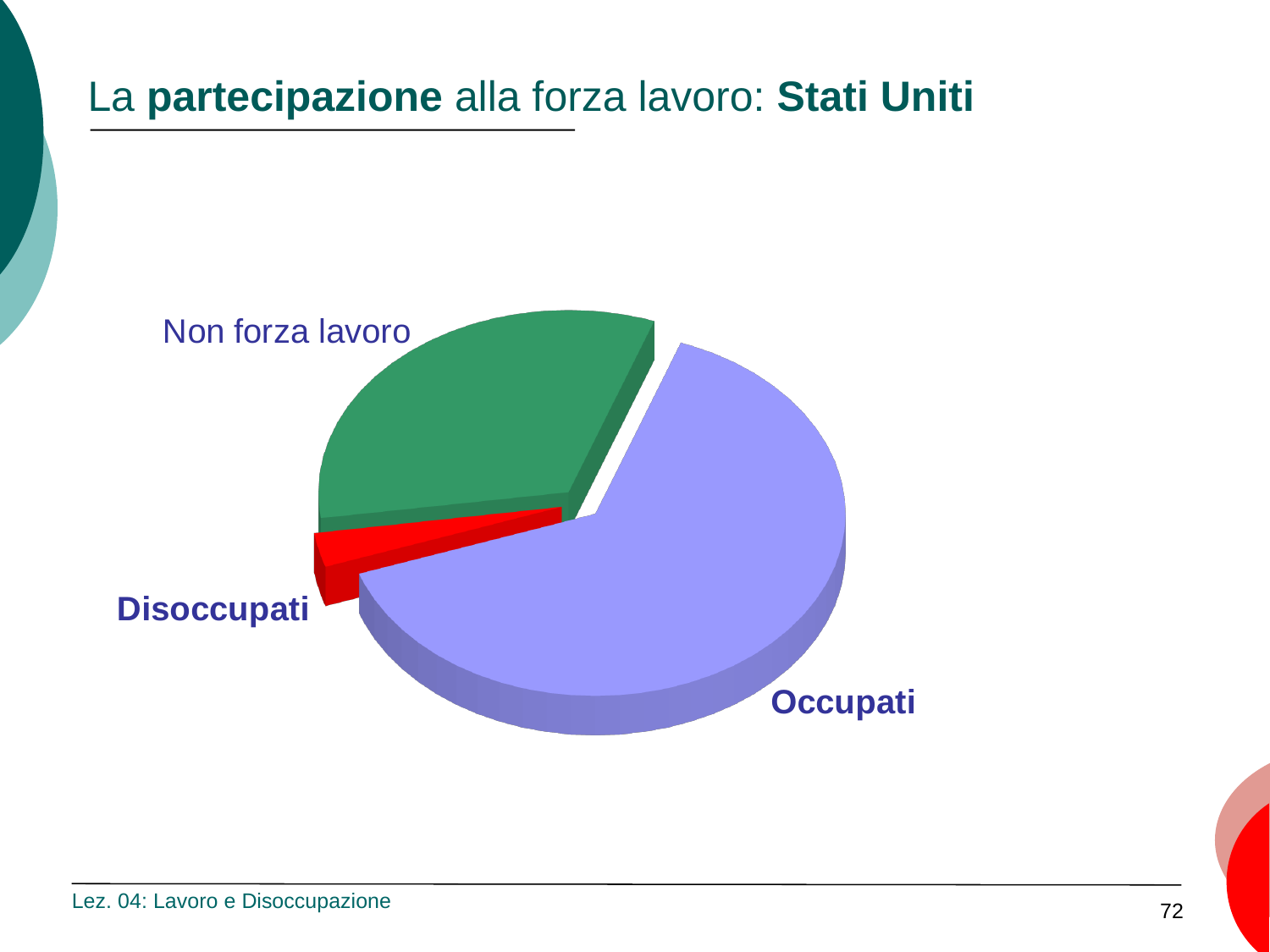
What kind of chart is shown on the slide? pie chart Does the Occupati slice represent more or less than half of the pie? more Which slice of the pie chart is the largest? Occupati What colour is the Disoccupati slice? red Which slice is larger, Occupati or Non forza lavoro? Occupati Which slice is larger, Non forza lavoro or Disoccupati? Non forza lavoro Which slice of the pie chart is the smallest? Disoccupati How many slices does the pie chart have? 3 What colour is the Occupati slice? light blue/purple